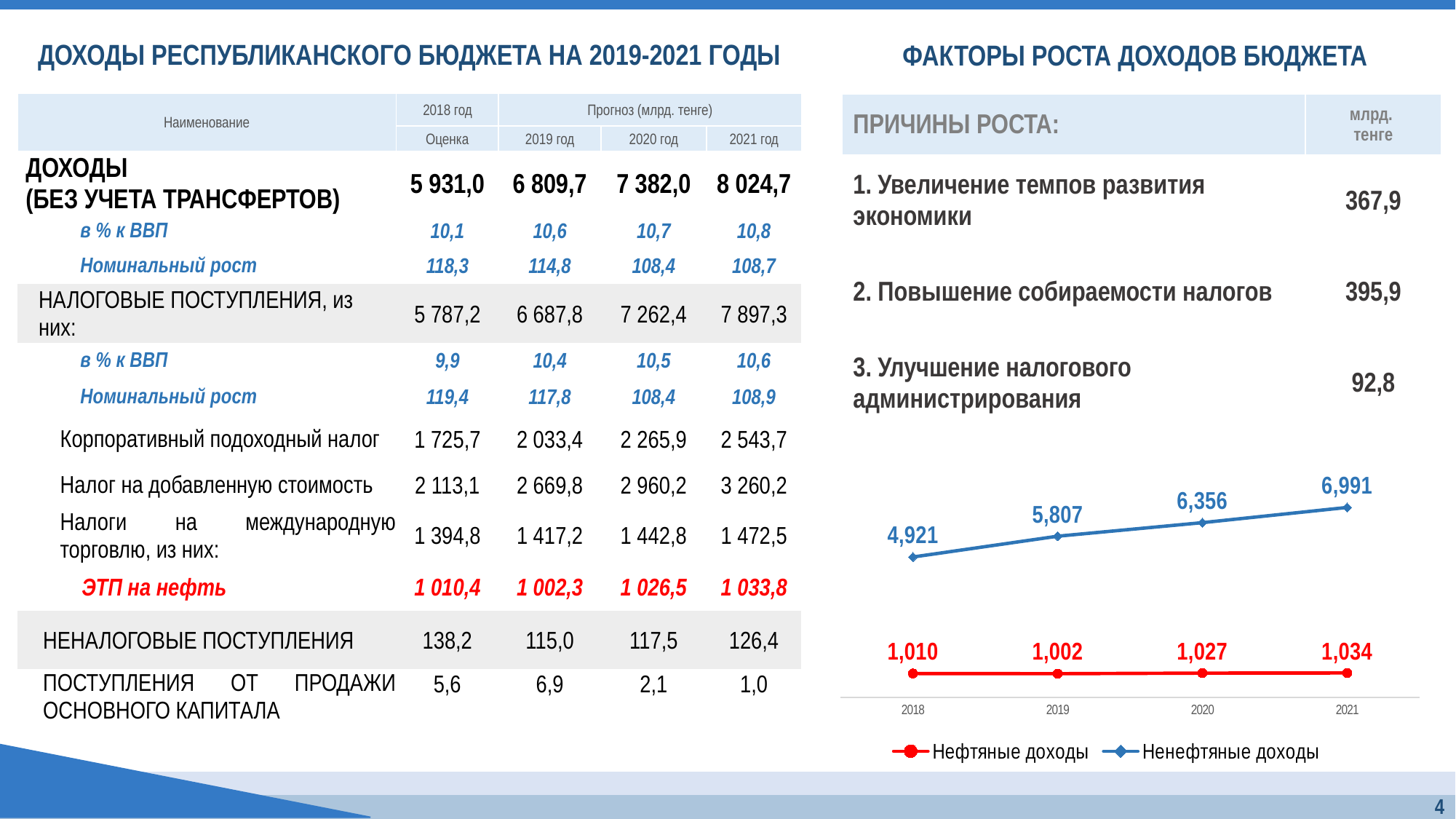
In the line chart on the right, what is the difference between Ненефтяные доходы in 2021 and in 2018? 2,070 In the line chart on the right, what is the value for Ненефтяные доходы in 2018? 4,921 In the line chart on the right, what is the difference between Ненефтяные доходы and Нефтяные доходы in 2021? 5,957 In the line chart on the right, how many series does the legend list? 2 In the line chart on the right, in which year is Нефтяные доходы lowest? 2019 In the line chart on the right, what is the value for Ненефтяные доходы in 2020? 6,356 In the line chart on the right, how many years are shown on the x axis? 4 In the line chart on the right, what is the value for Нефтяные доходы in 2019? 1,002 In the line chart on the right, in which year is Ненефтяные доходы highest? 2021 In the line chart on the right, what is the value for Нефтяные доходы in 2021? 1,034 What kind of chart is shown on the right side of the slide? line chart In the line chart on the right, which series has the larger value in 2020, Нефтяные доходы or Ненефтяные доходы? Ненефтяные доходы